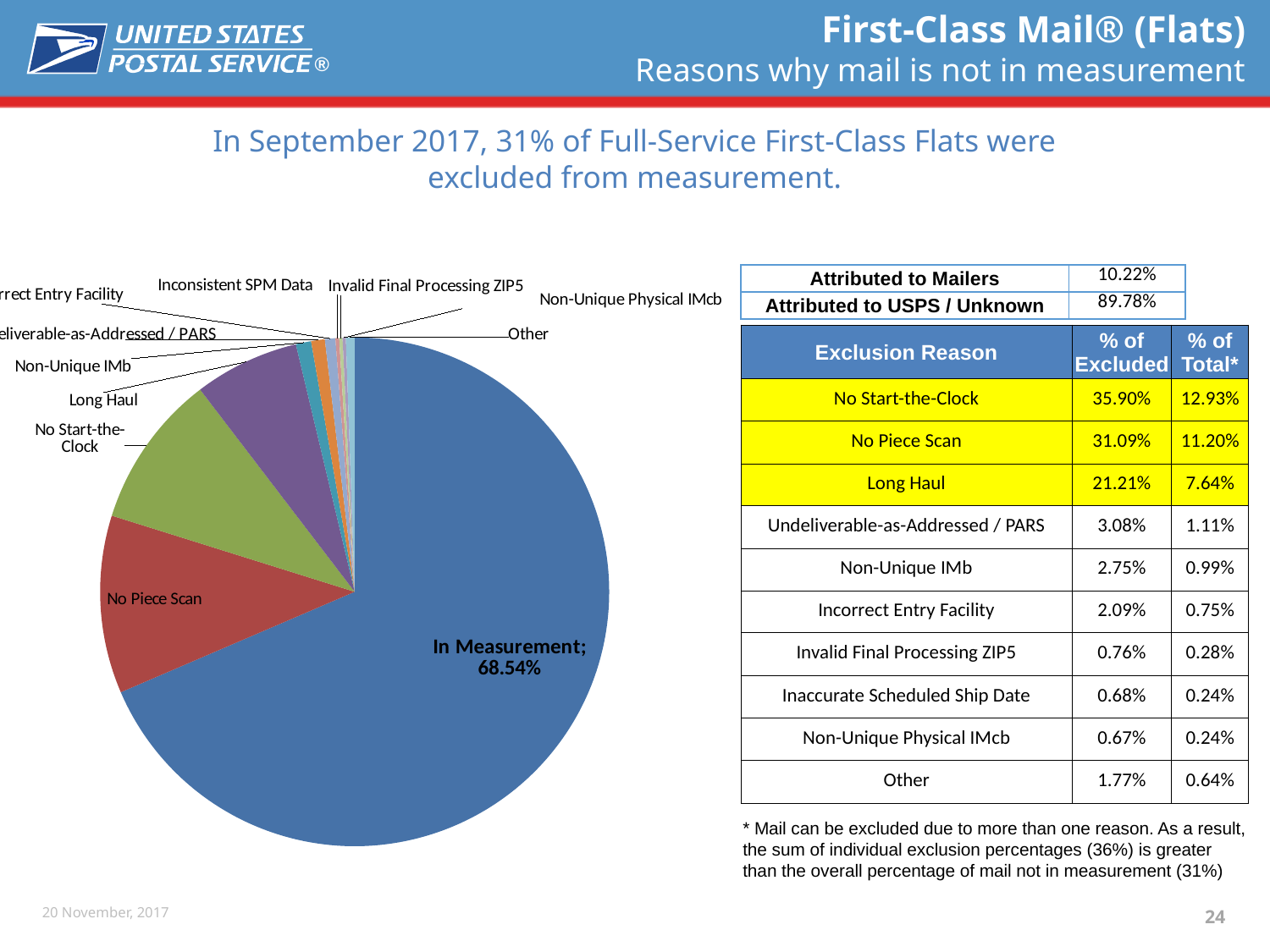
What colour is the No Piece Scan slice of the pie chart? red Is the In Measurement slice of the pie chart greater or less than 50%? greater What share of the pie does the In Measurement slice represent? 68.54% Which slice of the pie chart is the largest? In Measurement Which slice of the pie chart is larger, In Measurement or No Piece Scan? In Measurement Which slice of the pie chart is larger, No Start-the-Clock or Long Haul? No Start-the-Clock Which slice of the pie chart is larger, No Piece Scan or Other? No Piece Scan What percentage is shown for the In Measurement slice of the pie chart? 68.54% What colour is the In Measurement slice of the pie chart? blue What kind of chart is shown on the slide? pie chart